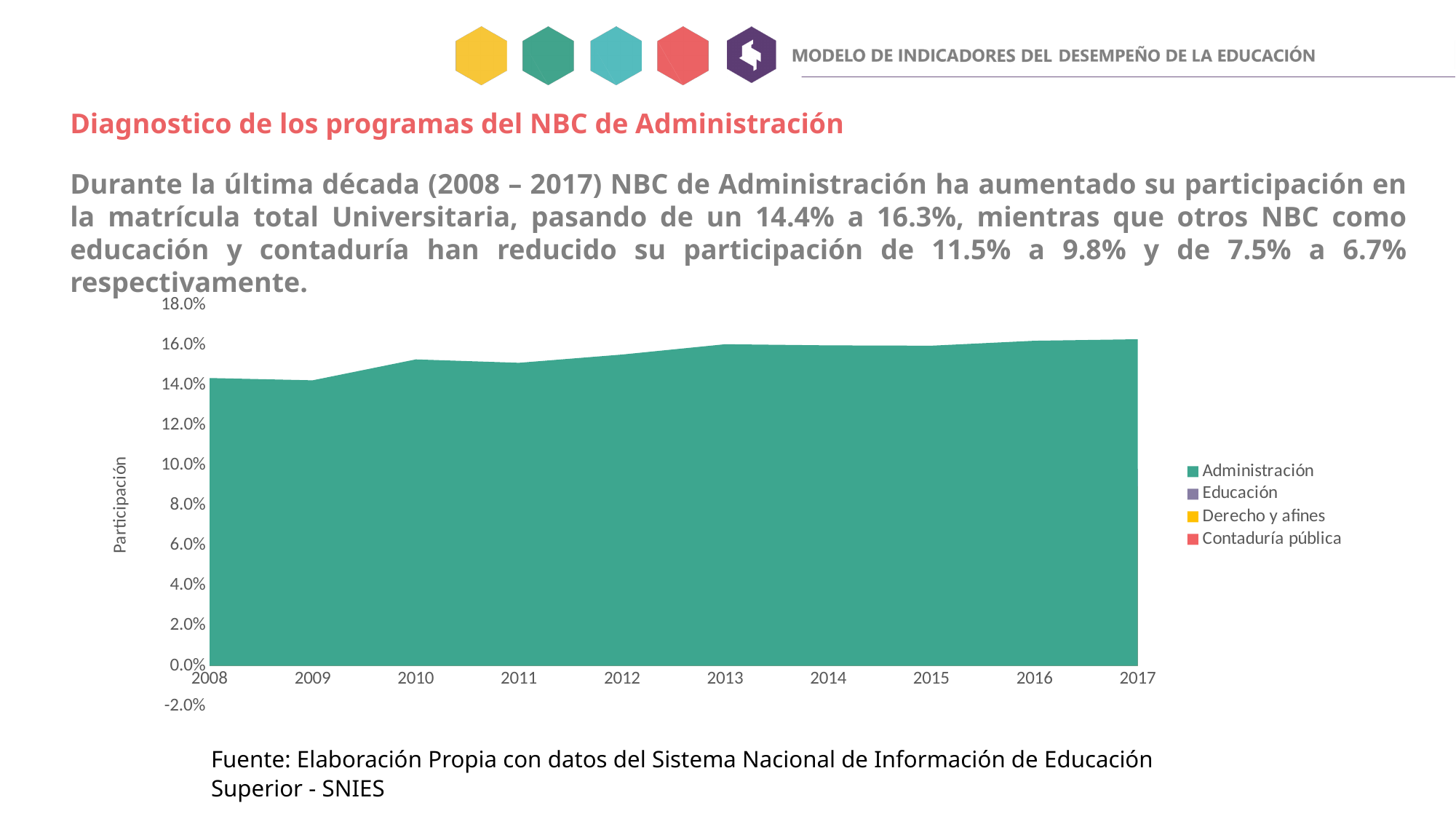
Does the Administración participation rise or fall from 2008 to 2017? Rise Is the value for Administración in 2010 greater or less than 12.0%? greater Which is larger, the Administración value in 2013 or in 2008? 2013 How many series does the legend list? 4 Which is larger, the Administración value in 2009 or in 2015? 2015 What kind of chart is shown on the slide? Area chart What is the label on the vertical axis of the chart? Participación How many years are shown along the x axis? 10 Is the value for Administración in 2013 greater or less than 14.0%? greater What colour is used for the Administración series in the legend? Green Is the value for Administración in 2017 greater or less than 18.0%? less